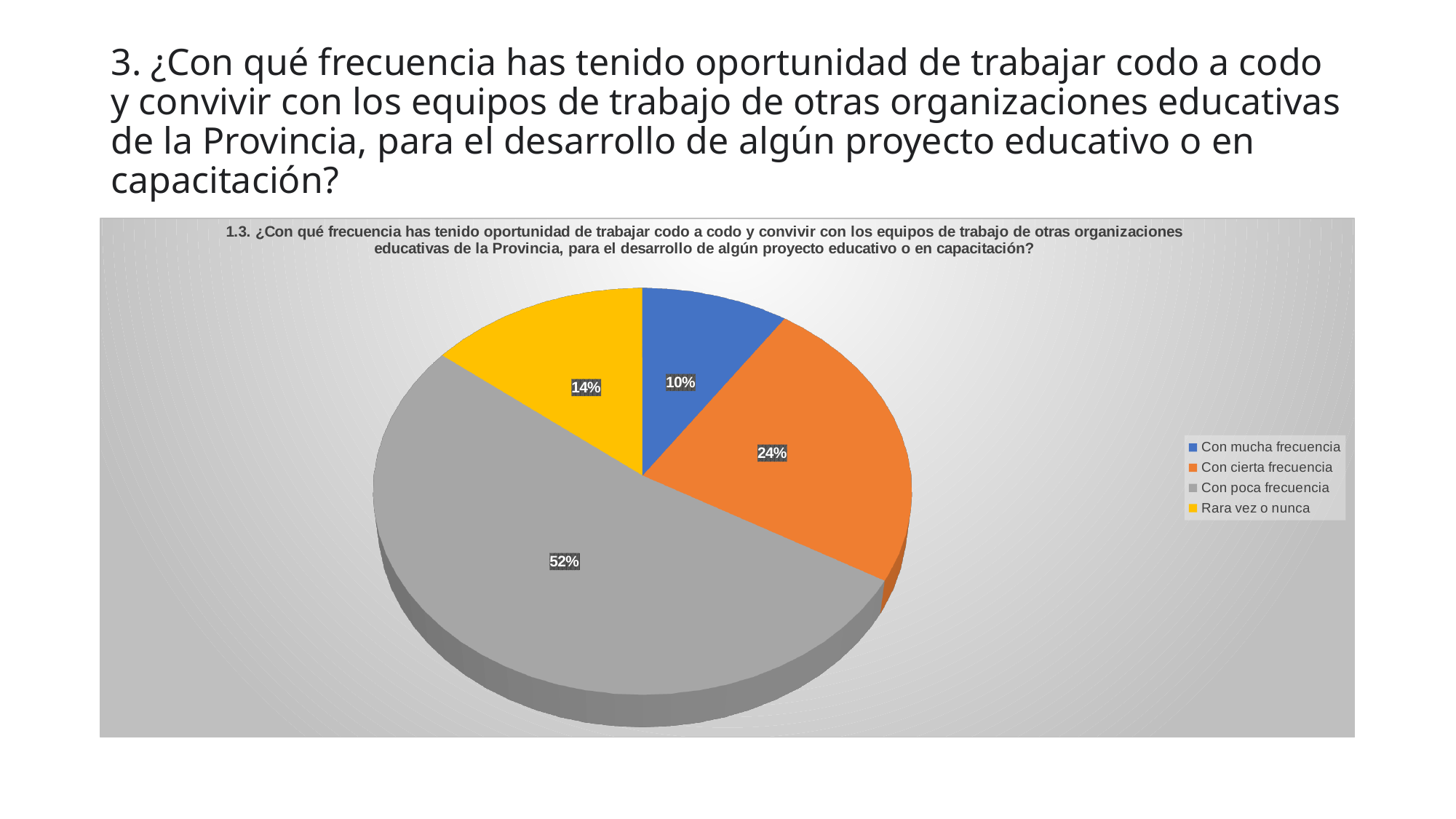
What share of the pie does "Con mucha frecuencia" represent? 10% What share of the pie does "Rara vez o nunca" represent? 14% What kind of chart is shown on the slide? pie chart What colour is the slice for "Rara vez o nunca"? yellow Which category has the largest slice of the pie? Con poca frecuencia Which category has the smallest slice of the pie? Con mucha frecuencia How many entries does the legend list? 4 What share of the pie does "Con poca frecuencia" represent? 52% Which is larger, the slice for "Rara vez o nunca" or the slice for "Con mucha frecuencia"? Rara vez o nunca How many categories does the pie chart have? 4 What is the difference in percentage points between "Con poca frecuencia" and "Con cierta frecuencia"? 28